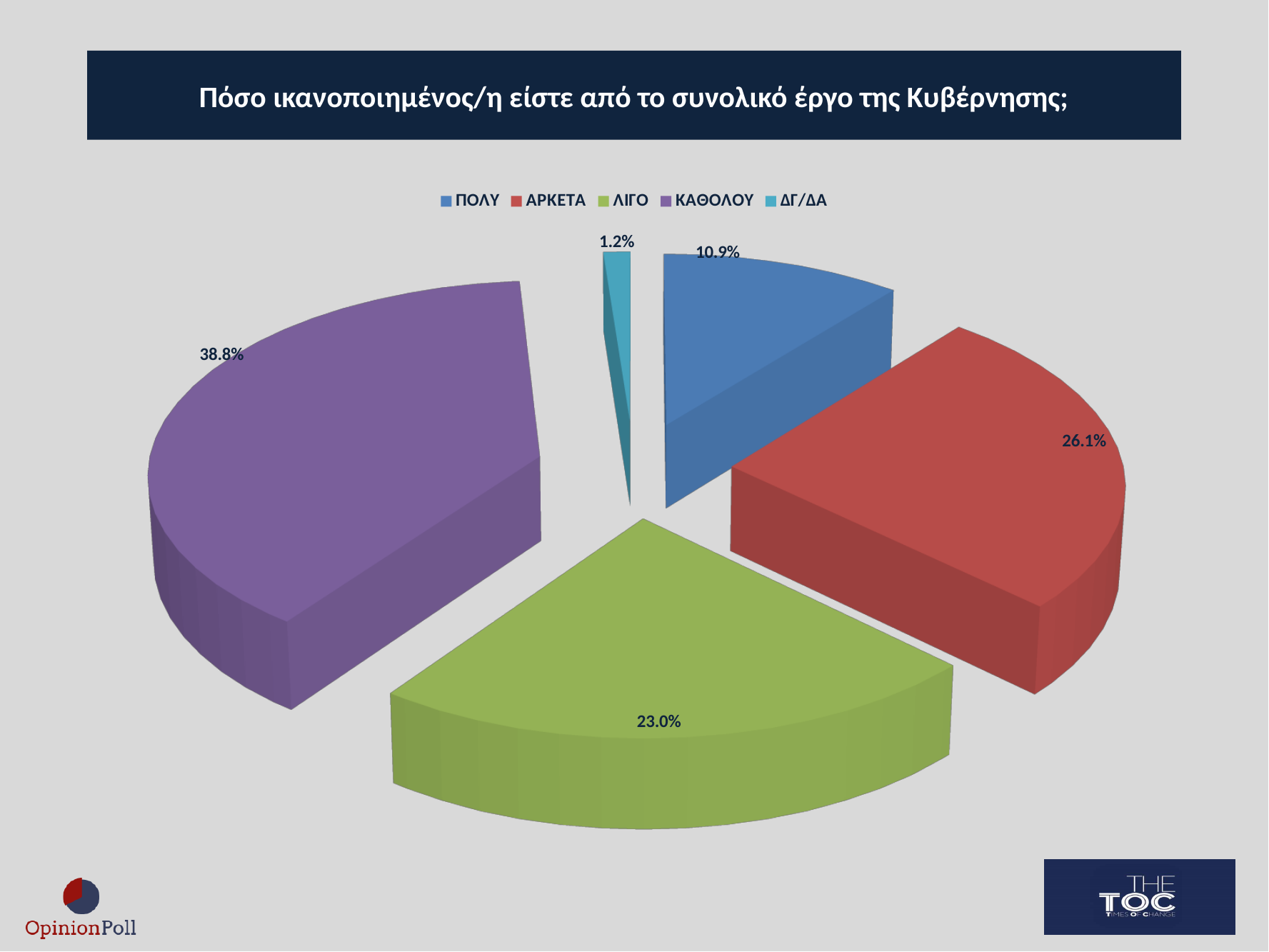
What is the value for ΠΟΛΥ? 10.9% Which is larger, the value for ΑΡΚΕΤΑ or the value for ΛΙΓΟ? ΑΡΚΕΤΑ What is the title of the chart? Πόσο ικανοποιημένος/η είστε από το συνολικό έργο της Κυβέρνησης; What is the value for ΛΙΓΟ? 23.0% What is the value for ΑΡΚΕΤΑ? 26.1% What kind of chart is shown on the slide? Pie chart Which category has the smallest share of the pie? ΔΓ/ΔΑ What is the value for ΔΓ/ΔΑ? 1.2% What is the value for ΚΑΘΟΛΟΥ? 38.8% Which category has the largest share of the pie? ΚΑΘΟΛΟΥ What is the difference between the values for ΚΑΘΟΛΟΥ and ΑΡΚΕΤΑ? 12.7% How many categories does the legend list? 5